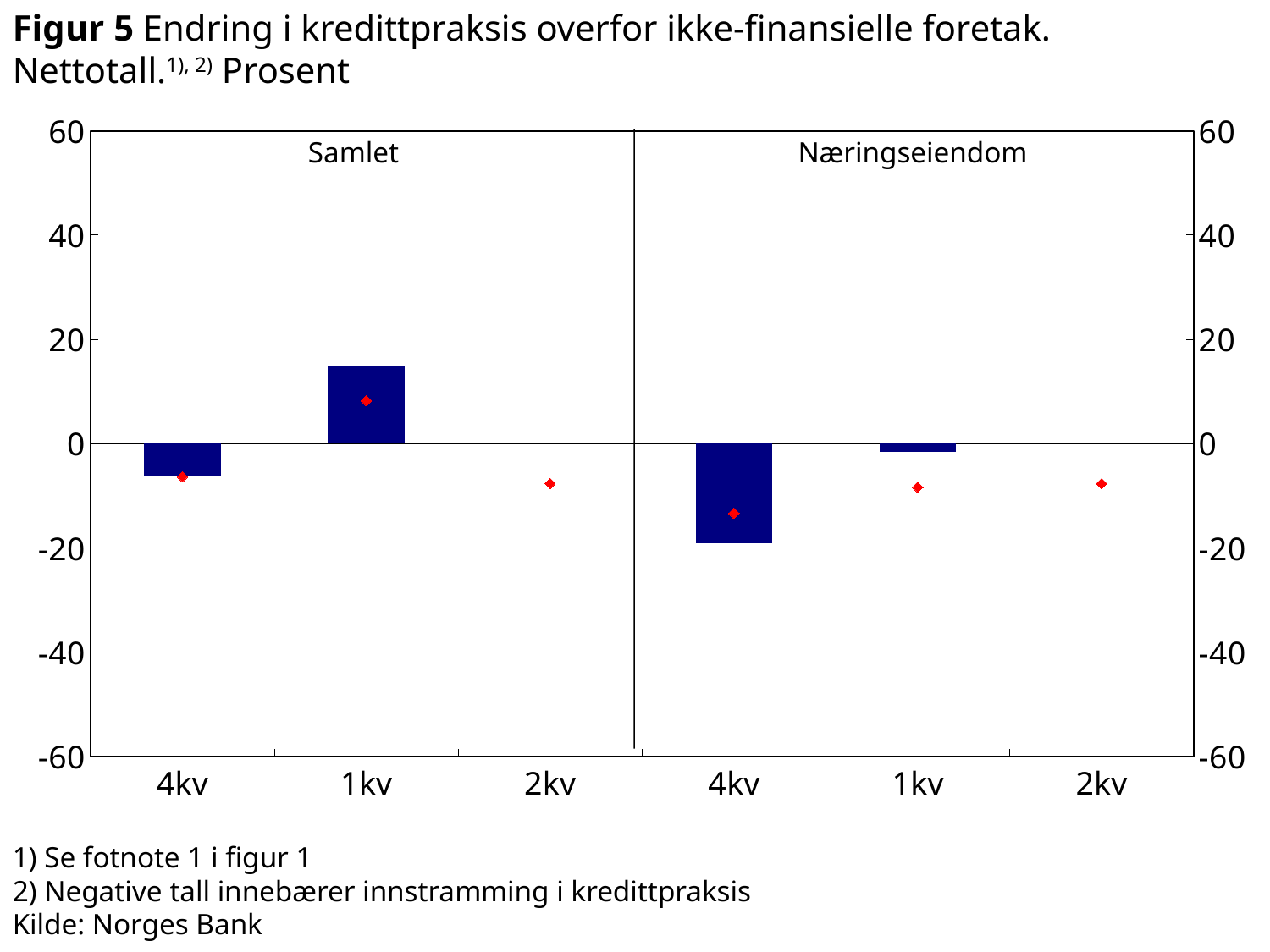
In the Samlet panel, which quarter has the highest bar? 1kv Is the bar for 1kv in the Samlet panel greater or less than 0? greater In the Næringseiendom panel, which is larger, the bar for 4kv or the bar for 1kv? 1kv What are the titles of the two panels in the chart? Samlet and Næringseiendom Is the bar for 4kv in the Næringseiendom panel greater or less than 0? less Is the bar for 1kv in the Samlet panel greater or less than 20? less What kind of chart is shown on the slide? Bar chart In the Næringseiendom panel, which quarter has the lowest bar? 4kv Which is larger, the bar for 4kv in the Samlet panel or the bar for 4kv in the Næringseiendom panel? Samlet 4kv According to the slide, what is the source of the chart data? Norges Bank How many quarters are shown on the x axis of the Samlet panel? 3